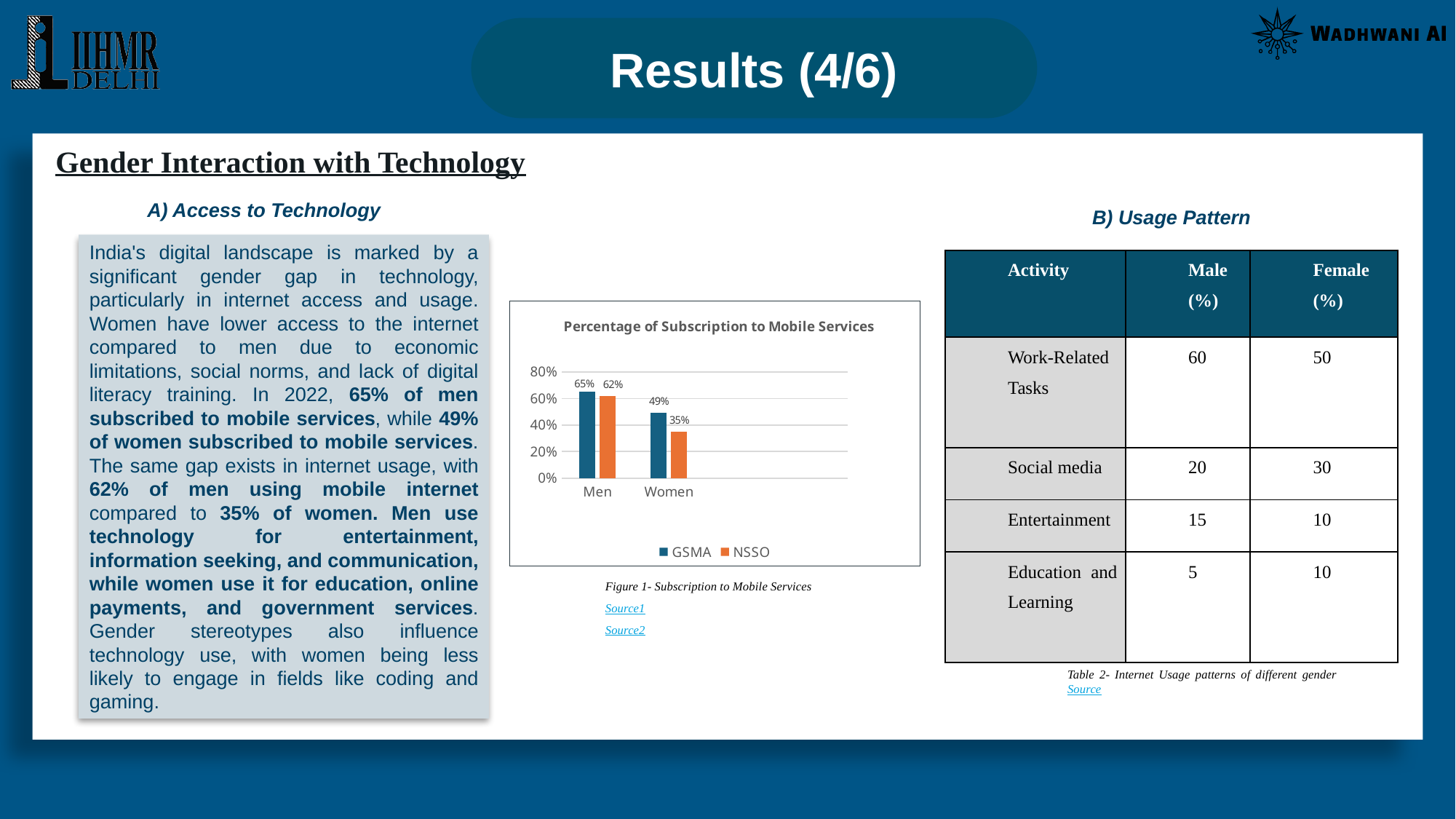
What is the GSMA value for Women in the 'Percentage of Subscription to Mobile Services' chart? 49% What is the NSSO value for Men in the 'Percentage of Subscription to Mobile Services' chart? 62% What is the NSSO value for Women in the 'Percentage of Subscription to Mobile Services' chart? 35% Which category has the lowest NSSO value in the 'Percentage of Subscription to Mobile Services' chart? Women Which category has the highest GSMA value in the 'Percentage of Subscription to Mobile Services' chart? Men How many series does the legend of the 'Percentage of Subscription to Mobile Services' chart list? 2 What is the difference between the GSMA values for Men and Women in the 'Percentage of Subscription to Mobile Services' chart? 16% What is the difference between the NSSO values for Men and Women in the 'Percentage of Subscription to Mobile Services' chart? 27% What is the GSMA value for Men in the 'Percentage of Subscription to Mobile Services' chart? 65% What kind of chart is the 'Percentage of Subscription to Mobile Services' chart? Bar chart How many categories are shown on the x axis of the 'Percentage of Subscription to Mobile Services' chart? 2 In the 'Percentage of Subscription to Mobile Services' chart, is the GSMA value for Women larger or the NSSO value for Women? GSMA